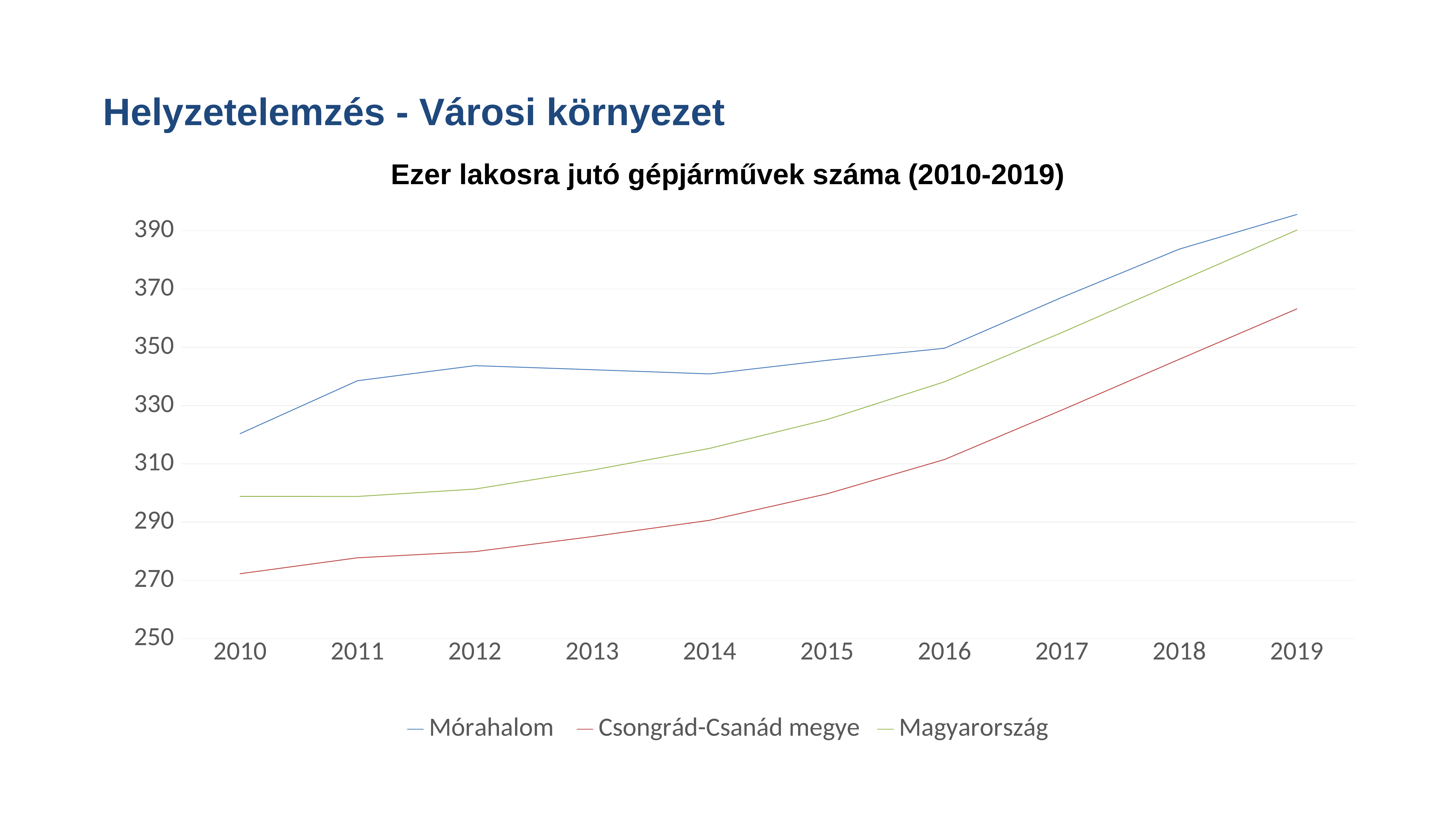
In 2019, which is larger: the value for Mórahalom or the value for Csongrád-Csanád megye? Mórahalom What colour is the line for Magyarország? green How many years are plotted along the x axis? 10 Is the value for Magyarország in 2010 greater or less than 310? less How many series does the legend list? 3 What kind of chart is shown on the slide? line chart Is the value for Csongrád-Csanád megye in 2019 greater or less than 350? greater Which series has the lowest value in 2010? Csongrád-Csanád megye Does the value for Csongrád-Csanád megye rise or fall from 2010 to 2019? rise Is the value for Mórahalom in 2016 greater or less than 330? greater What is the title of the chart? Ezer lakosra jutó gépjárművek száma (2010-2019)